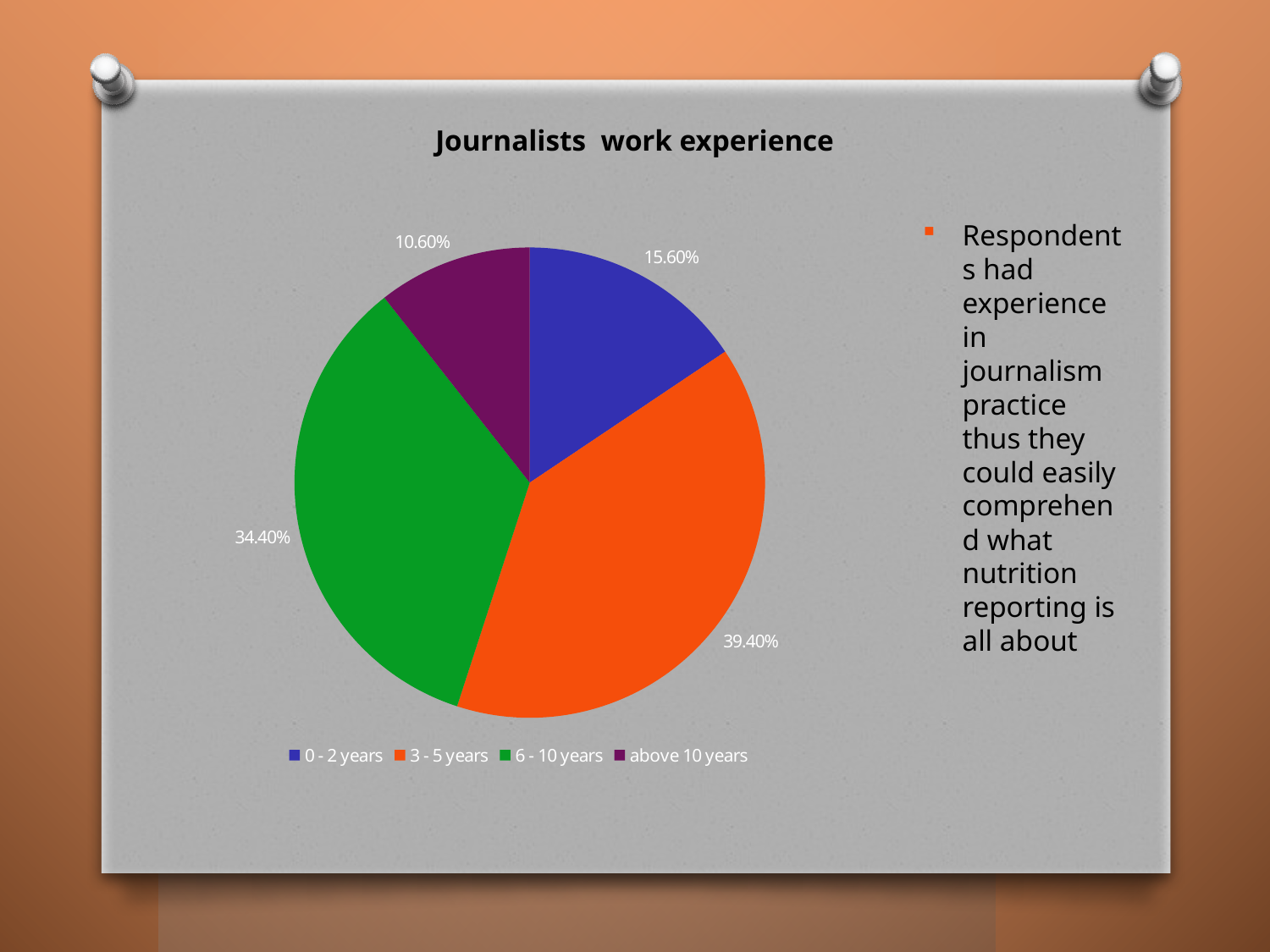
Which work experience category has the smallest share? above 10 years What share of journalists have 0 - 2 years of work experience? 15.60% Which is larger, the share for 0 - 2 years or the share for above 10 years? 0 - 2 years What share of journalists have 6 - 10 years of work experience? 34.40% Which work experience category has the largest share? 3 - 5 years How many categories does the pie chart show? 4 What is the difference between the shares for 3 - 5 years and 6 - 10 years? 5.00% What share of journalists have 3 - 5 years of work experience? 39.40% What is the title of the chart? Journalists work experience What type of chart is shown on the slide? pie chart Which colour represents the 6 - 10 years category in the legend? green What share of journalists have above 10 years of work experience? 10.60%